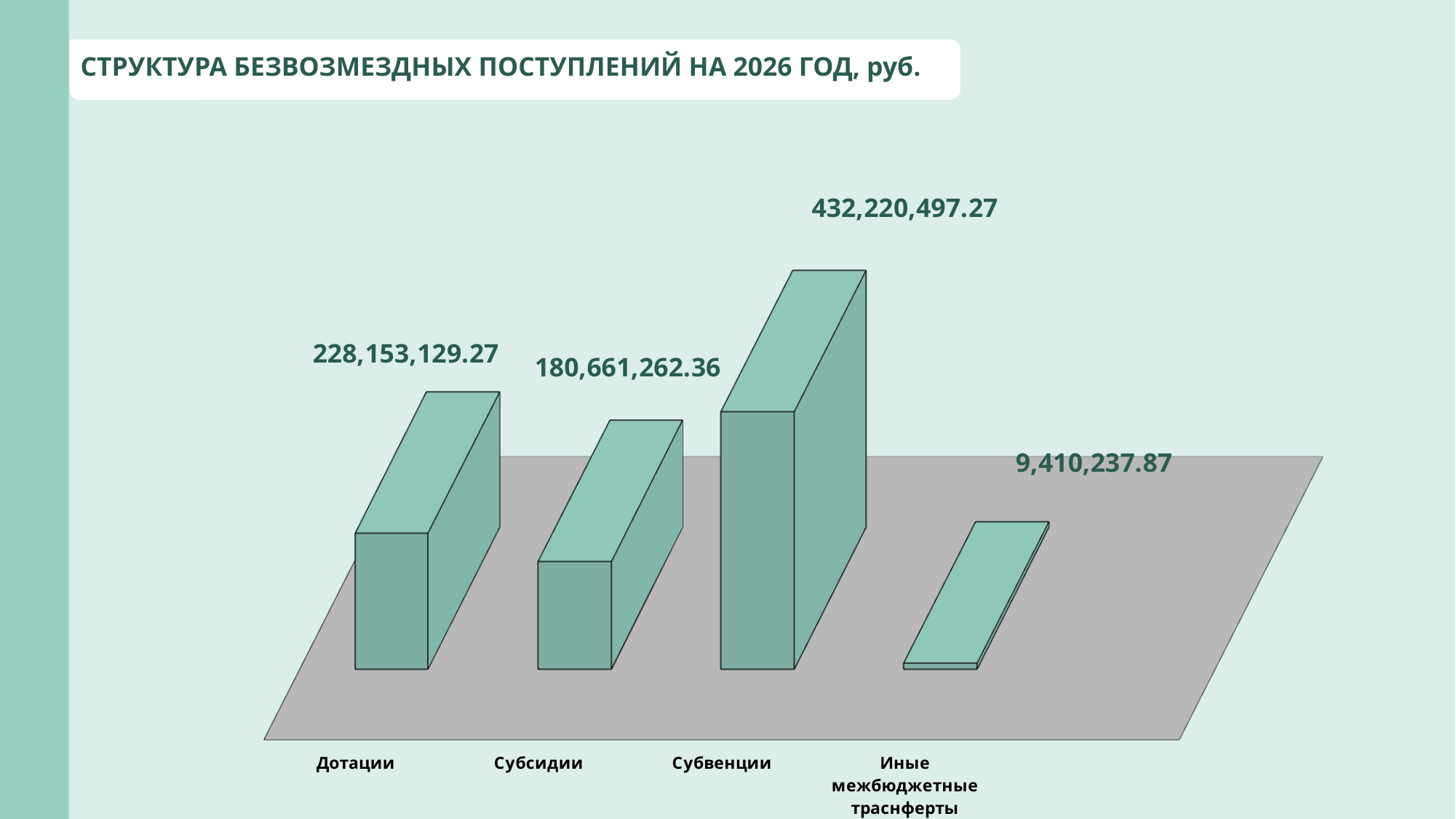
What is the value for Иные межбюджетные трансферты? 9,410,237.87 Which category has the lowest value? Иные межбюджетные трансферты What is the value for Субвенции? 432,220,497.27 Which category has the highest value? Субвенции How many categories are shown in the chart? 4 What is the value for Дотации? 228,153,129.27 What is the difference between the values for Субвенции and Дотации? 204,067,368.00 What kind of chart is shown on the slide? Bar chart What is the title of the chart? СТРУКТУРА БЕЗВОЗМЕЗДНЫХ ПОСТУПЛЕНИЙ НА 2026 ГОД, руб. Which is larger, the value for Дотации or the value for Субсидии? Дотации What is the difference between the values for Дотации and Субсидии? 47,491,866.91 What is the value for Субсидии? 180,661,262.36